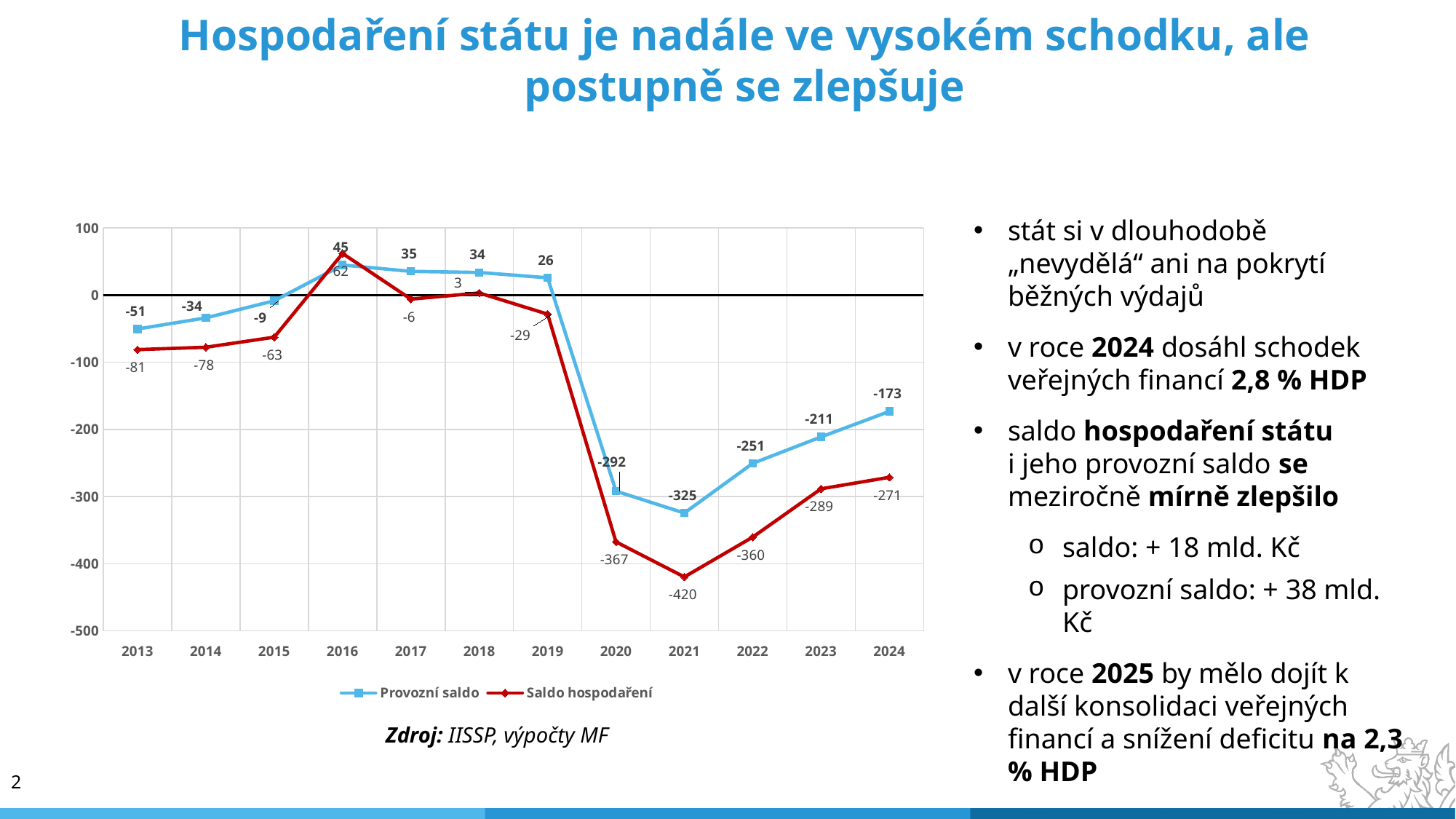
What is the value of Provozní saldo in 2024? -173 What is the value of Saldo hospodaření in 2021? -420 What kind of chart is shown on the slide? line chart What is the value of Saldo hospodaření in 2016? 62 Does Provozní saldo rise or fall from 2021 to 2024? rise Which series has the higher value in 2020, Provozní saldo or Saldo hospodaření? Provozní saldo How many series does the legend list? 2 In which year is Provozní saldo at its highest? 2016 In which year is Saldo hospodaření at its lowest? 2021 How many years are shown on the x axis? 12 What is the source given below the chart? IISSP, výpočty MF What is the difference between Provozní saldo and Saldo hospodaření in 2024? 98